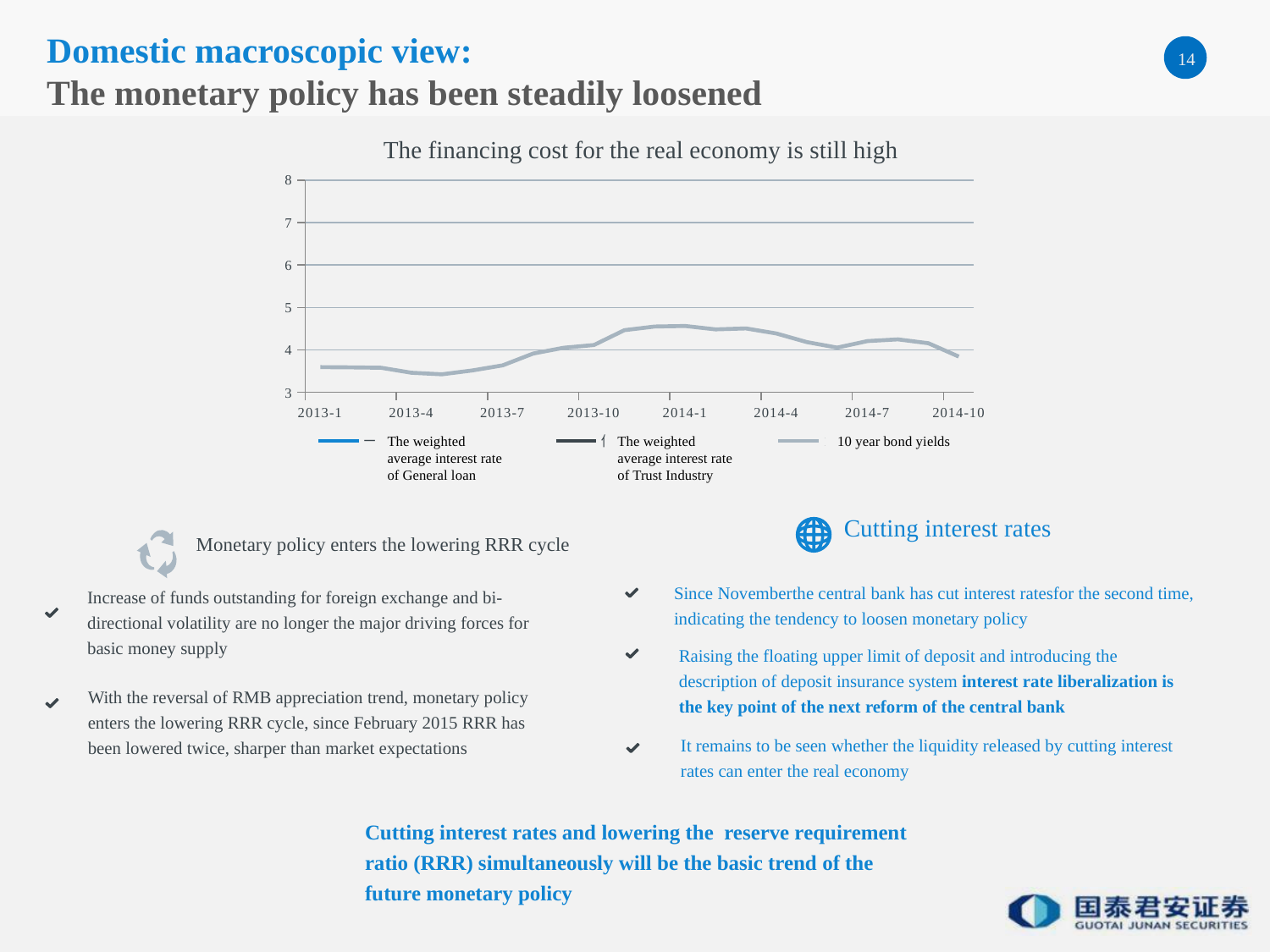
What is the title of the chart? The financing cost for the real economy is still high Does the 10 year bond yields line rise or fall between 2014-1 and 2014-10? fall How many series does the chart's legend list? 3 How many date labels are shown on the x axis of the chart? 8 Is the value of the 10 year bond yields line at 2014-1 greater or less than 4? greater Does the 10 year bond yields line rise or fall between 2013-4 and 2014-1? rise Which series is plotted in grey according to the legend? 10 year bond yields Is the 10 year bond yields value higher at 2013-1 or at 2014-1? 2014-1 Is the value of the 10 year bond yields line at 2013-1 greater or less than 4? less Is the value of the 10 year bond yields line at 2014-10 greater or less than 4? less What kind of chart is shown on the slide? line chart